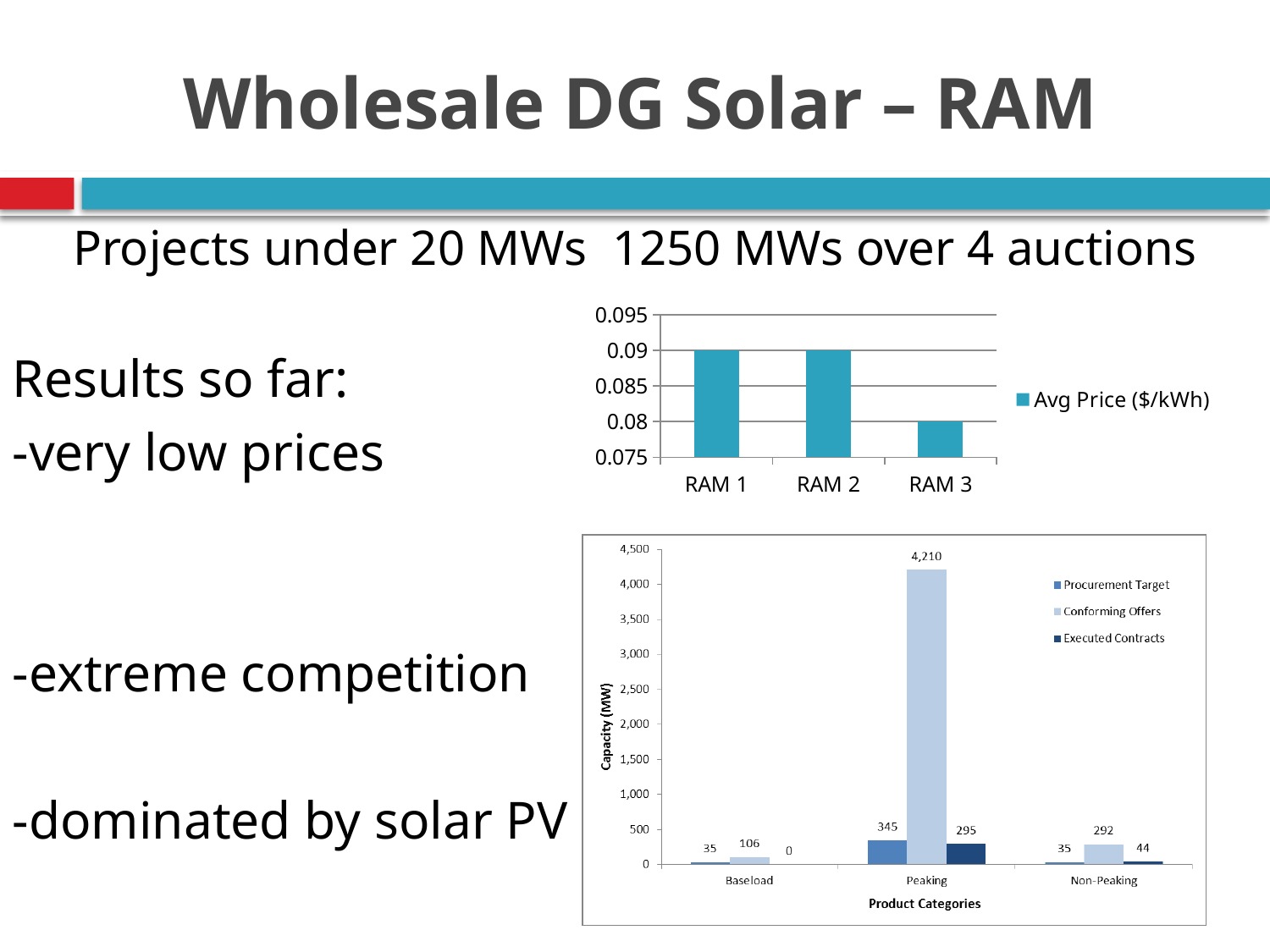
In the bottom chart (Capacity by Product Categories), what is the label of the y axis? Capacity (MW) In the bottom chart (Capacity by Product Categories), how many series does the legend list? 3 In the top chart (Avg Price), what kind of chart is it? bar chart In the bottom chart (Capacity by Product Categories), what is the value of Executed Contracts for Baseload? 0 In the top chart (Avg Price), what is the average price for RAM 1? 0.09 In the bottom chart (Capacity by Product Categories), what is the value of Conforming Offers for Peaking? 4,210 In the bottom chart (Capacity by Product Categories), which is larger for Non-Peaking: Conforming Offers or Executed Contracts? Conforming Offers In the bottom chart (Capacity by Product Categories), what is the Procurement Target for Non-Peaking? 35 In the top chart (Avg Price), how many auctions are shown on the x axis? 3 In the top chart (Avg Price), which auction has the lowest average price? RAM 3 In the bottom chart (Capacity by Product Categories), what is the difference between the Procurement Target and Executed Contracts for Peaking? 50 In the top chart (Avg Price), what is the average price for RAM 3? 0.08